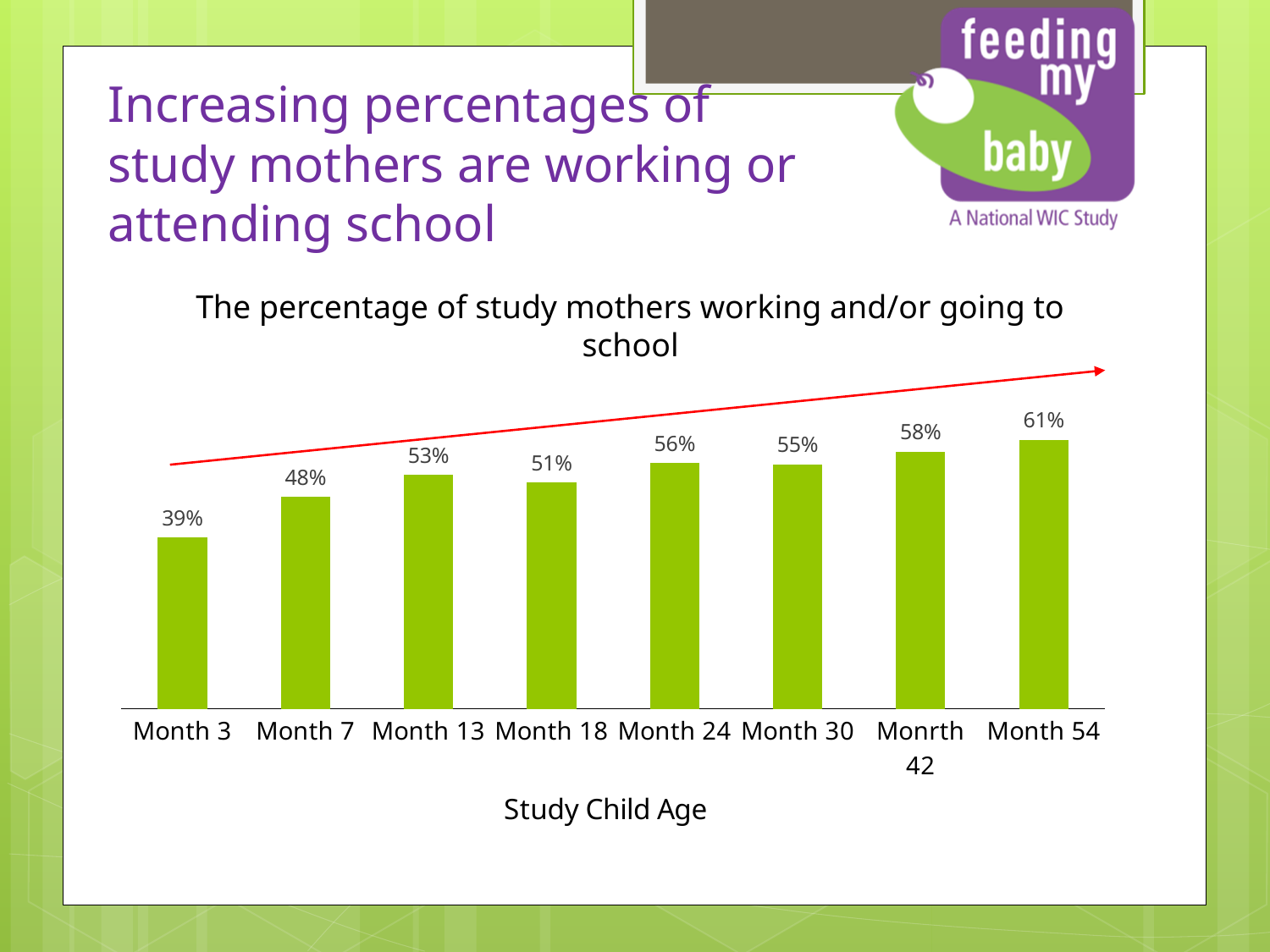
What is the label of the x axis of the chart? Study Child Age Which study child age has the highest percentage of mothers working and/or going to school? Month 54 What is the value shown for Month 24? 56% Which is larger, the value for Month 7 or the value for Month 30? Month 30 What percentage of study mothers were working and/or going to school at Month 3? 39% What is the difference in percentage points between Month 54 and Month 3? 22 How many study child age categories are shown on the chart? 8 Which study child age has the lowest percentage? Month 3 What percentage is shown for Month 54? 61% Overall, do the values rise or fall from Month 3 to Month 54? Rise What kind of chart is shown on the slide? Bar chart What is the difference between the values for Month 13 and Month 18? 2